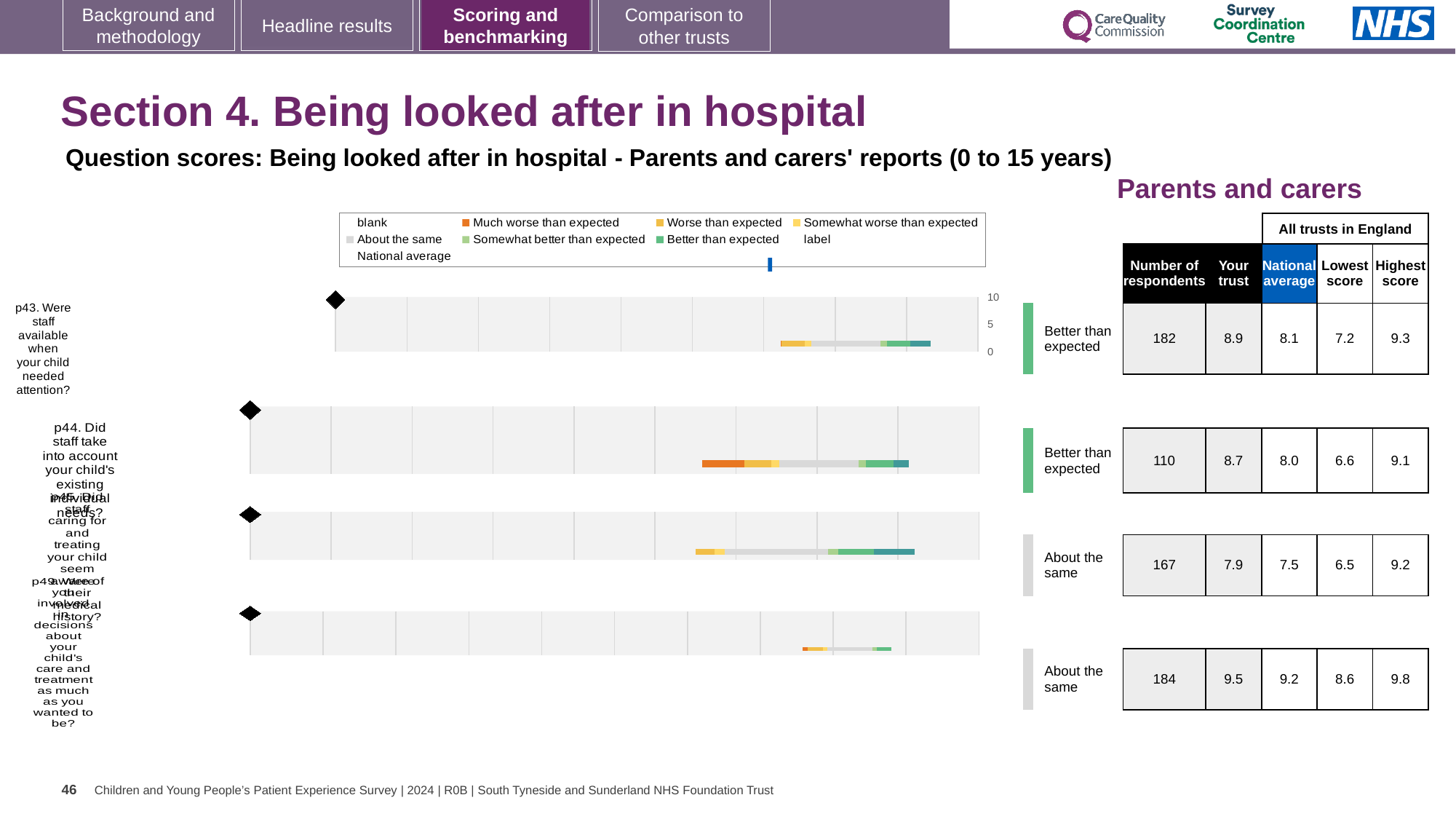
Which question has the lowest 'Your trust' score in the table beside the chart? p45 In the table beside the chart, what is the national average for p44 (Did staff take into account your child's existing individual needs?)? 8.0 In the table beside the chart, what is the 'Your trust' score for p43 (Were staff available when your child needed attention?)? 8.9 What is the subtitle of the chart on this slide? Question scores: Being looked after in hospital - Parents and carers' reports (0 to 15 years) What benchmark category is shown next to the chart for p45? About the same Which has the higher 'Your trust' score, p44 or p45? p44 How many questions (rows) are plotted in the chart? 4 What is the highest score across all trusts in England for p44? 9.1 For p43, what is the difference between the 'Your trust' score and the national average? 0.8 Which question has the highest 'Your trust' score in the table beside the chart? p49 What kind of chart is used to show the question scores on this slide? bar chart How many respondents are listed for p49 in the table beside the chart? 184